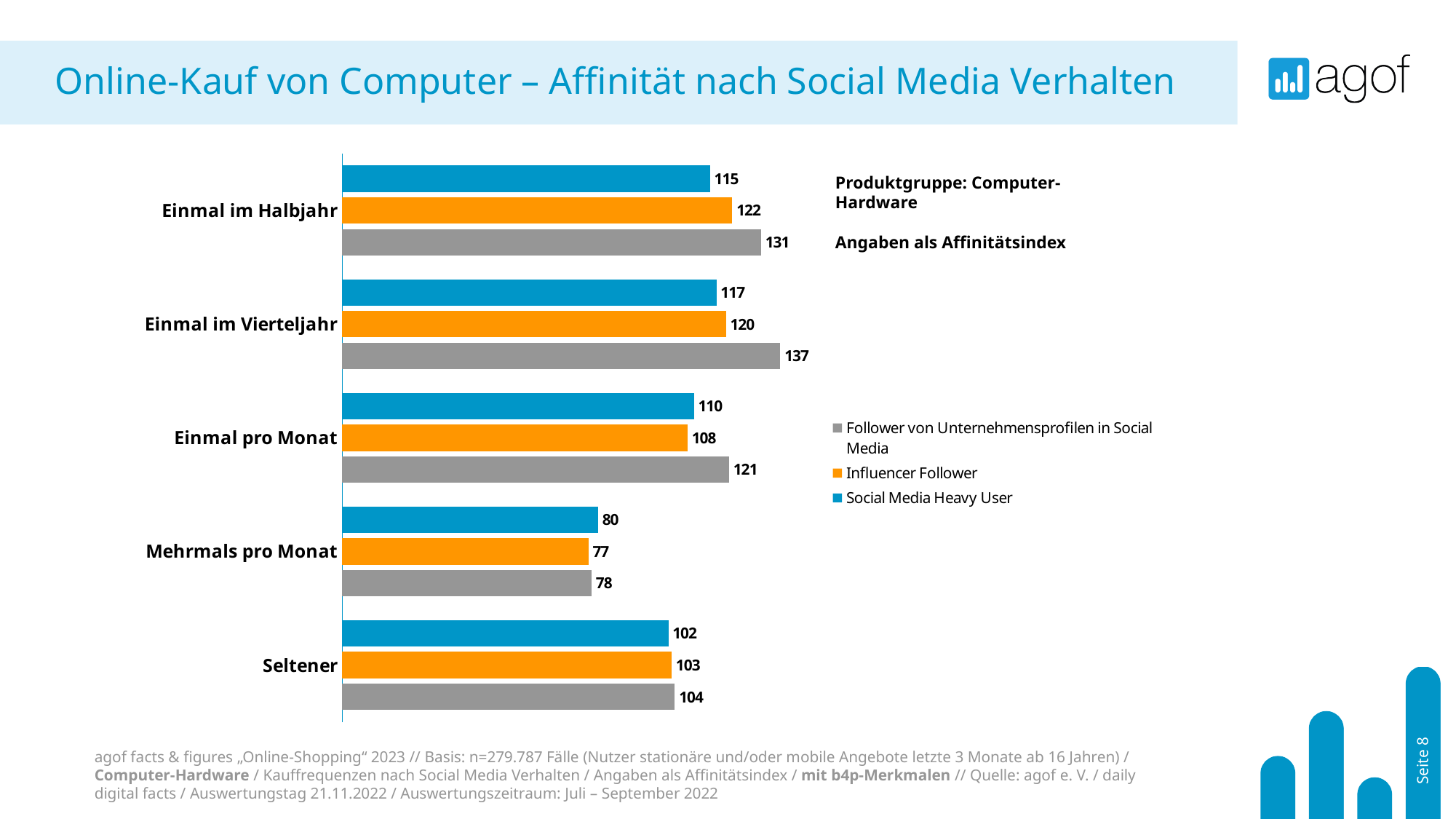
Which category has the highest value for Follower von Unternehmensprofilen in Social Media? Einmal im Vierteljahr What is the difference between the Follower von Unternehmensprofilen in Social Media value and the Social Media Heavy User value in the category Einmal im Vierteljahr? 20 How many categories are shown on the chart? 5 Which category has the lowest value for Social Media Heavy User? Mehrmals pro Monat Which colour represents the Influencer Follower series? Orange What is the value for Influencer Follower in the category Einmal im Vierteljahr? 120 What is the value for Influencer Follower in the category Mehrmals pro Monat? 77 What kind of chart is shown on the slide? Bar chart What is the value for Follower von Unternehmensprofilen in Social Media in the category Einmal pro Monat? 121 What is the value for Social Media Heavy User in the category Einmal im Halbjahr? 115 Which is larger in the category Einmal im Halbjahr: the Influencer Follower value or the Social Media Heavy User value? Influencer Follower How many series does the legend list? 3